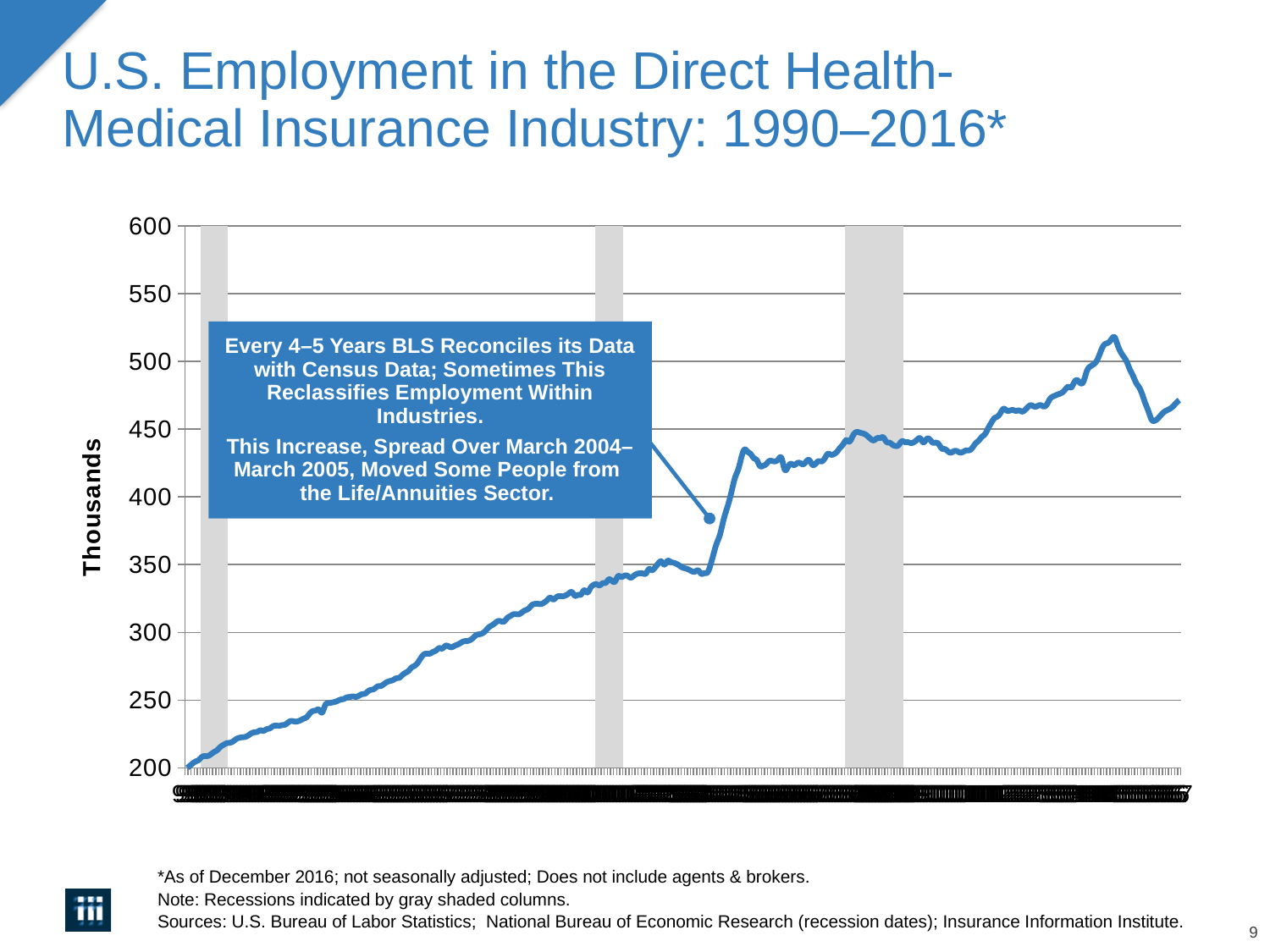
What kind of chart is shown on the slide? line chart What do the gray shaded columns on the chart indicate? Recessions Overall, does employment in the direct health-medical insurance industry rise or fall from 1990 to 2016? rise What is the highest value shown on the vertical axis? 600 What unit is shown on the vertical axis label? Thousands How many gray shaded recession columns appear on the chart? 3 Is the highest point reached by the line greater or less than 500? greater Is the value at the start of the series (1990) greater or less than 250? less Is the value at the end of the series (December 2016) greater or less than 450? greater